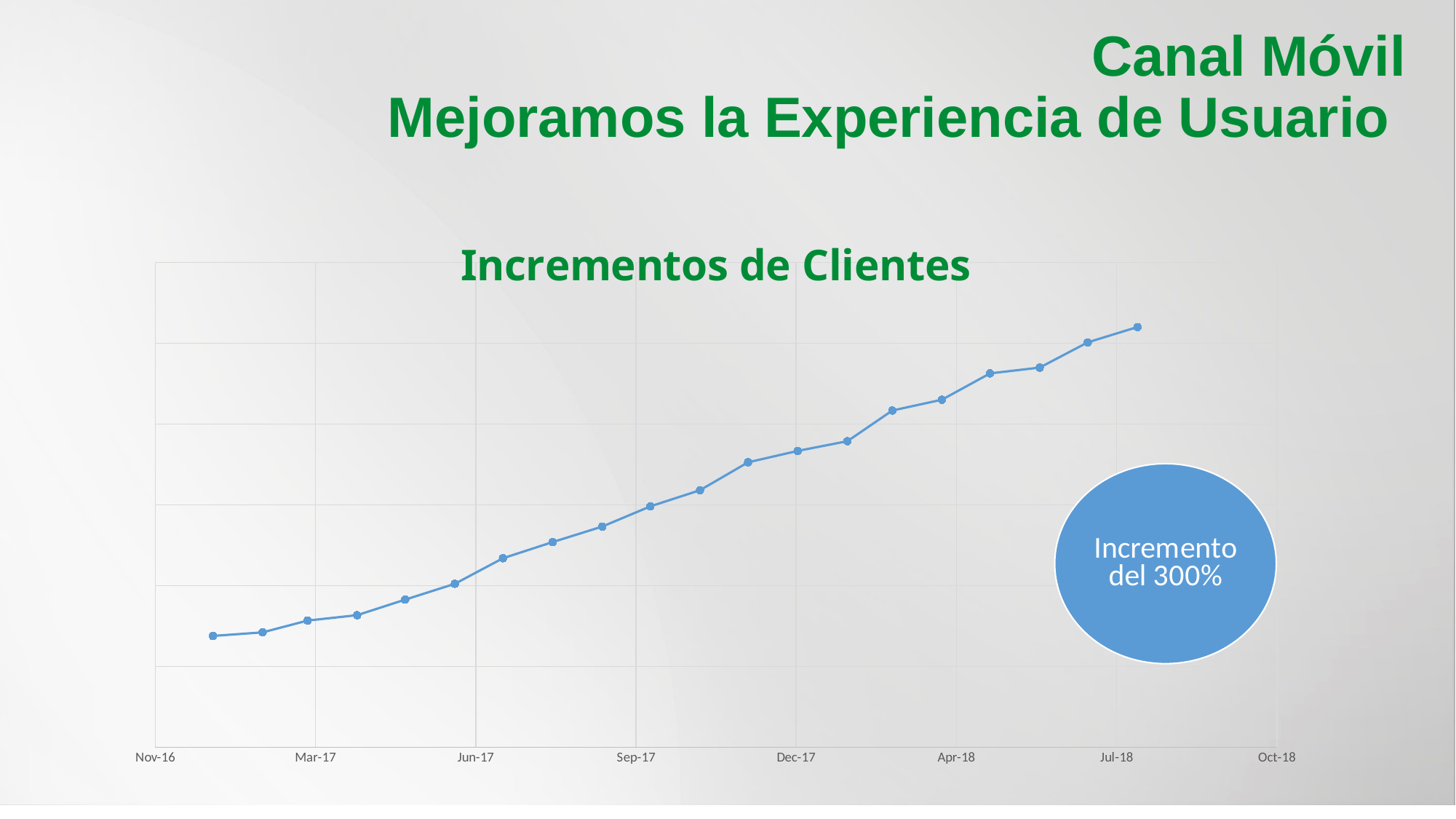
What is the title of the chart? Incrementos de Clientes Is the highest point of the line at the beginning or at the end of the series? at the end Is the lowest point of the line at the beginning or at the end of the series? at the beginning What percentage increase is stated in the blue circle next to the chart? 300% How many tick labels are shown on the x axis of the chart? 8 What is the last tick label on the x axis of the chart? Oct-18 How many data points are plotted on the line in the 'Incrementos de Clientes' chart? 20 How many lines (series) are plotted in the chart? 1 Which is larger: the value of the point near Jul-18 or the value of the point near Mar-17? the point near Jul-18 What is the first tick label on the x axis of the chart? Nov-16 Do the values in the 'Incrementos de Clientes' chart rise or fall from left to right along the x axis? rise What kind of chart is shown on the slide? line chart